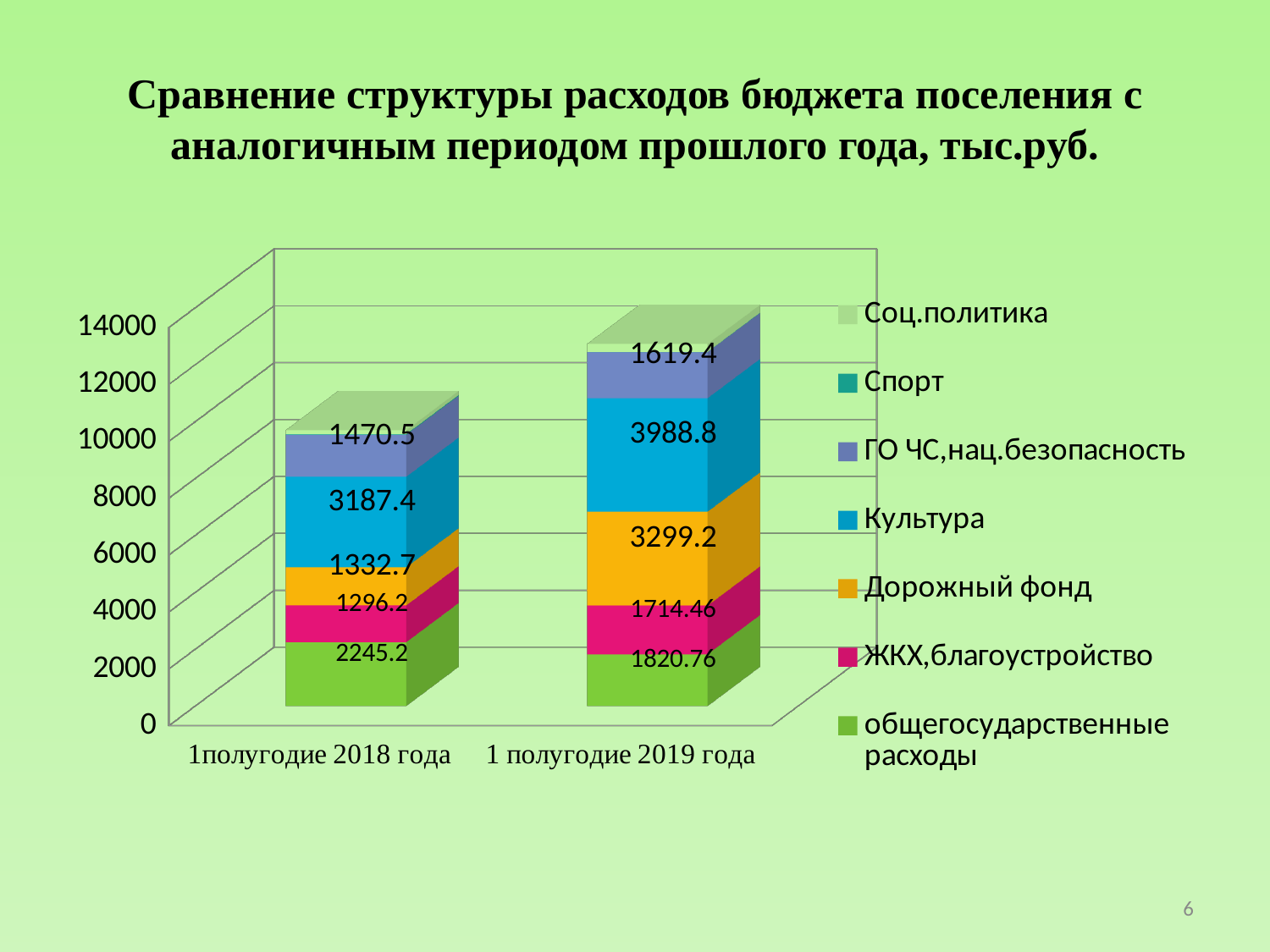
What is the difference between the Дорожный фонд values for 1 полугодие 2019 года and 1полугодие 2018 года? 1966.5 What is the value for Культура in 1полугодие 2018 года? 3187.4 How many series does the legend list? 7 How many periods (categories) are plotted on the x axis? 2 Which period has the larger value for ЖКХ,благоустройство? 1 полугодие 2019 года What is the value for ГО ЧС,нац.безопасность in 1полугодие 2018 года? 1470.5 What is the value for Дорожный фонд in 1 полугодие 2019 года? 3299.2 What is the value for общегосударственные расходы in 1 полугодие 2019 года? 1820.76 What kind of chart is shown on the slide? Stacked bar chart Is the total height of the 1полугодие 2018 года bar greater or less than 12000? less By how much did the value for Культура increase from 1полугодие 2018 года to 1 полугодие 2019 года? 801.4 Which series is listed first (at the top) in the legend? Соц.политика